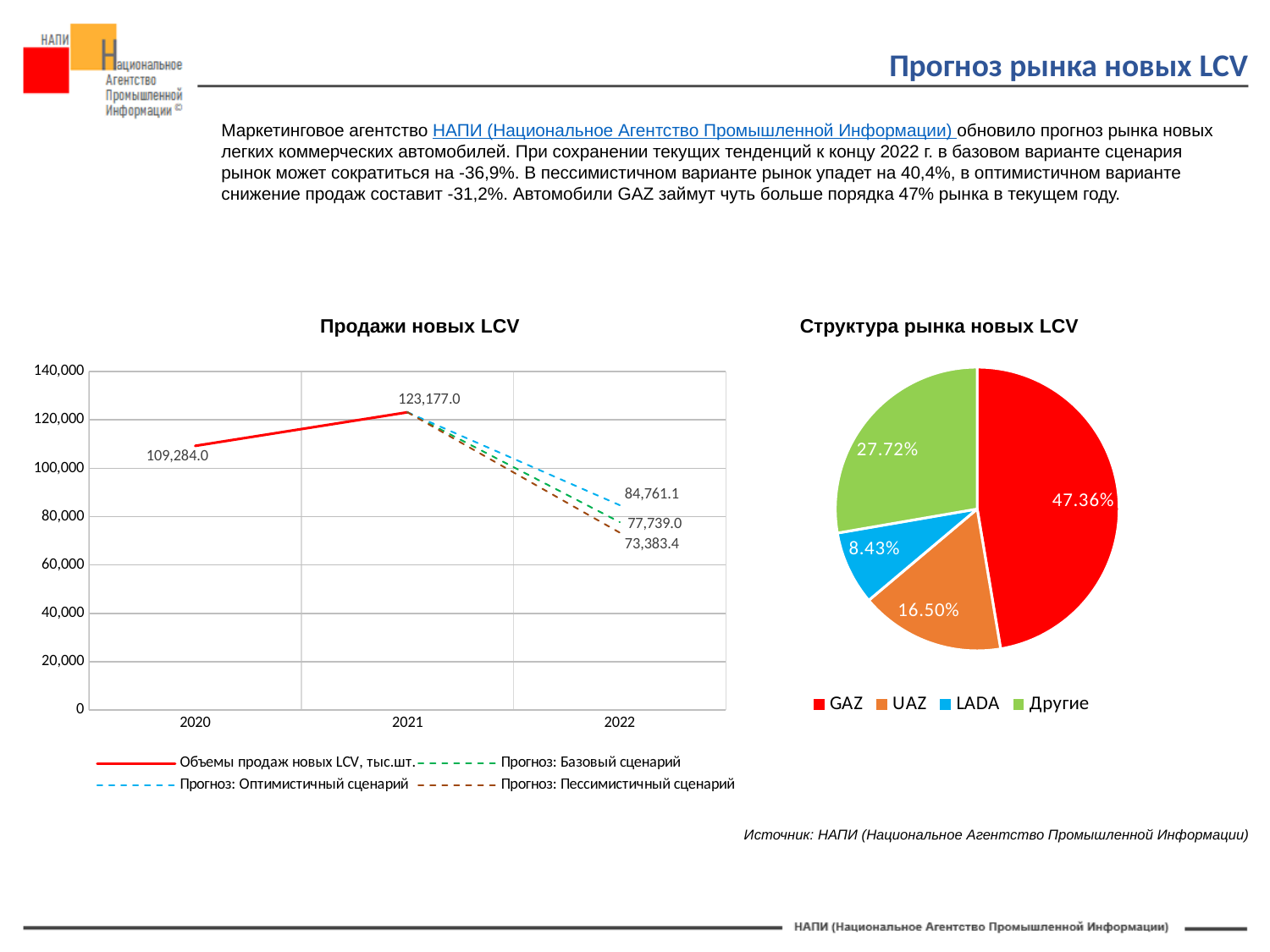
In the chart titled "Структура рынка новых LCV", what share does GAZ have? 47.36% In the chart titled "Продажи новых LCV", what is the value for 2021? 123,177.0 In the chart titled "Продажи новых LCV", what is the 2022 value for the series "Прогноз: Пессимистичный сценарий"? 73,383.4 In the chart titled "Продажи новых LCV", what is the 2022 value for the series "Прогноз: Оптимистичный сценарий"? 84,761.1 In the chart titled "Продажи новых LCV", which 2022 forecast scenario has the lowest value? Прогноз: Пессимистичный сценарий In the chart titled "Структура рынка новых LCV", how many slices does the pie have? 4 In the chart titled "Продажи новых LCV", what kind of chart is it? Line chart In the chart titled "Продажи новых LCV", what is the value for 2020? 109,284.0 In the chart titled "Структура рынка новых LCV", which is larger: UAZ or Другие? Другие In the chart titled "Продажи новых LCV", what is the difference between the 2021 value and the 2020 value? 13,893.0 In the chart titled "Структура рынка новых LCV", which category has the smallest slice? LADA In the chart titled "Продажи новых LCV", how many series does the legend list? 4